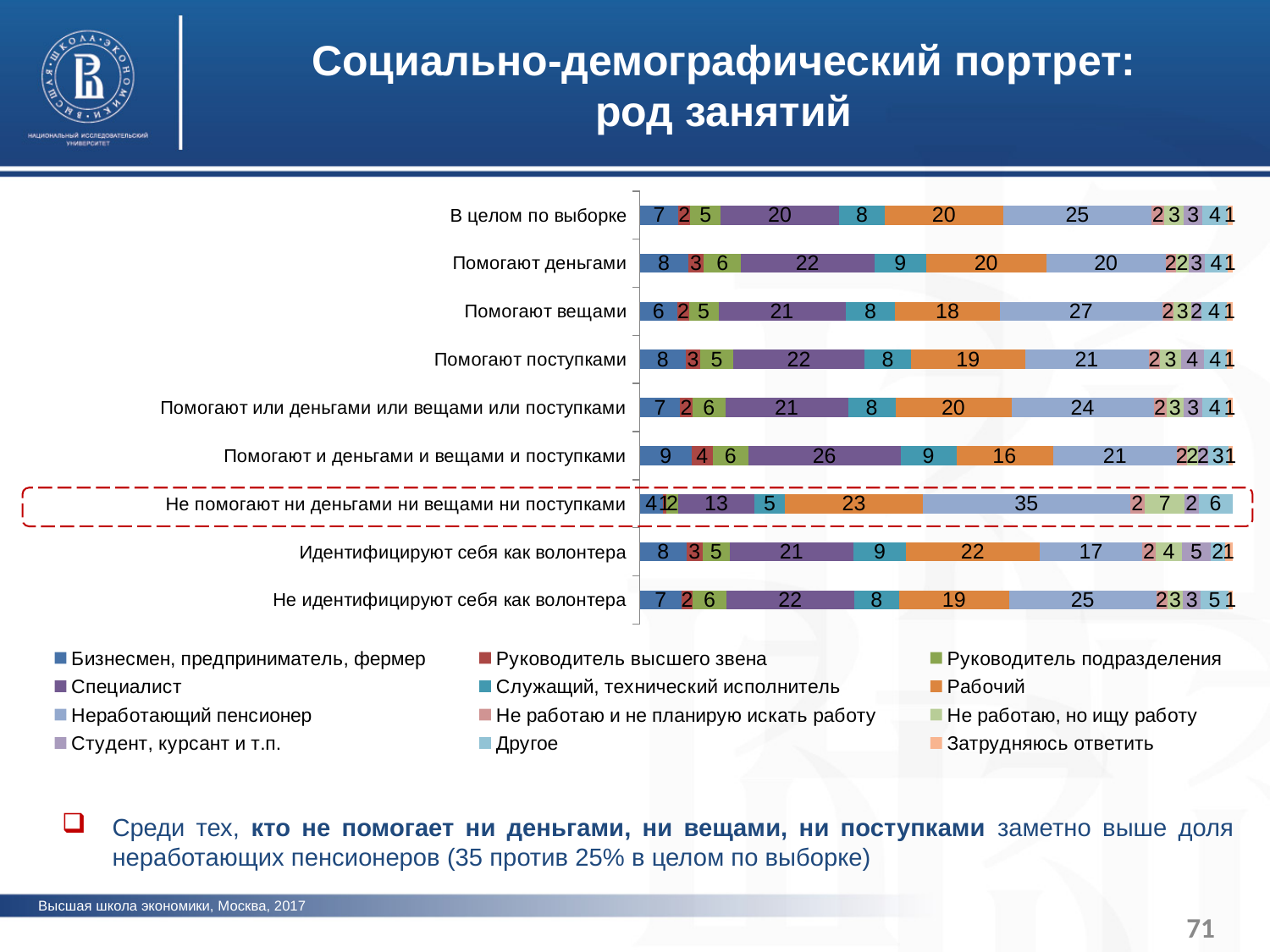
What is the value for 'Неработающий пенсионер' in the 'Не помогают ни деньгами ни вещами ни поступками' row? 35 Which row has the lowest value for 'Специалист'? Не помогают ни деньгами ни вещами ни поступками Which row of the chart is highlighted with a red dashed box? Не помогают ни деньгами ни вещами ни поступками How many categories (rows) are plotted in the chart? 9 Which row has the larger 'Рабочий' value: 'Идентифицируют себя как волонтера' or 'Не идентифицируют себя как волонтера'? Идентифицируют себя как волонтера How many series does the legend list? 12 What is the difference between the 'Неработающий пенсионер' value for 'Не помогают ни деньгами ни вещами ни поступками' and for 'В целом по выборке'? 10 What is the value for 'Рабочий' in the 'Идентифицируют себя как волонтера' row? 22 Which row has the highest value for 'Неработающий пенсионер'? Не помогают ни деньгами ни вещами ни поступками What is the value for 'Специалист' in the 'Помогают и деньгами и вещами и поступками' row? 26 What type of chart is shown on the slide? Stacked bar chart What is the value for 'Неработающий пенсионер' in the 'В целом по выборке' row? 25